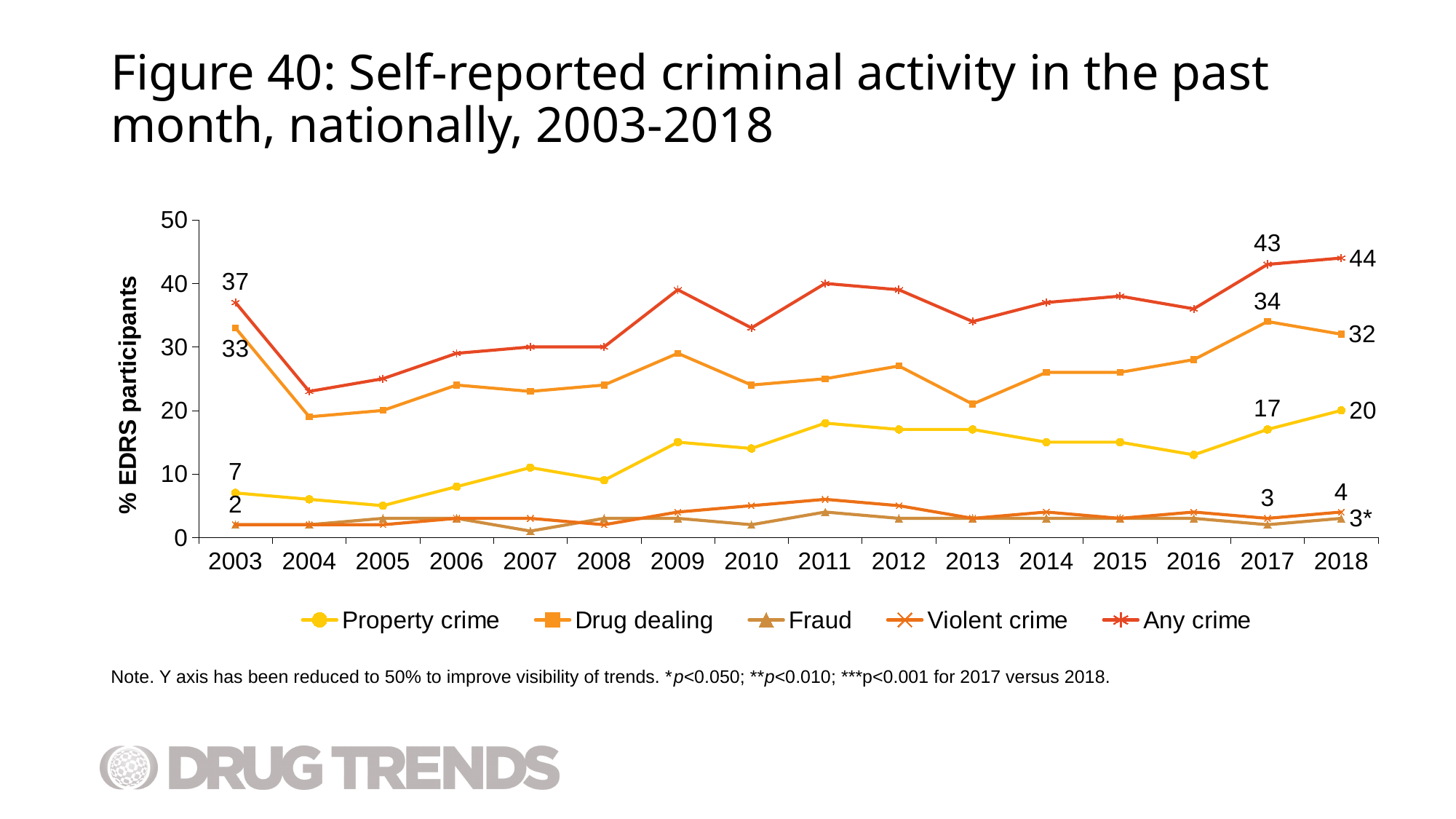
What kind of chart is shown on the slide? line chart Which series has the highest value in 2018? Any crime Is the value for Any crime in 2011 greater or less than 30? greater What is the value for Property crime in 2003? 7 How many years are shown on the x axis? 16 What is the difference between the Any crime values for 2018 and 2017? 1 What is the value for Any crime in 2018? 44 What is the value for Drug dealing in 2017? 34 By how much did Property crime increase from 2017 to 2018? 3 How many series does the legend list? 5 Which year has the higher Drug dealing value, 2017 or 2018? 2017 What is the value for Violent crime in 2018? 4